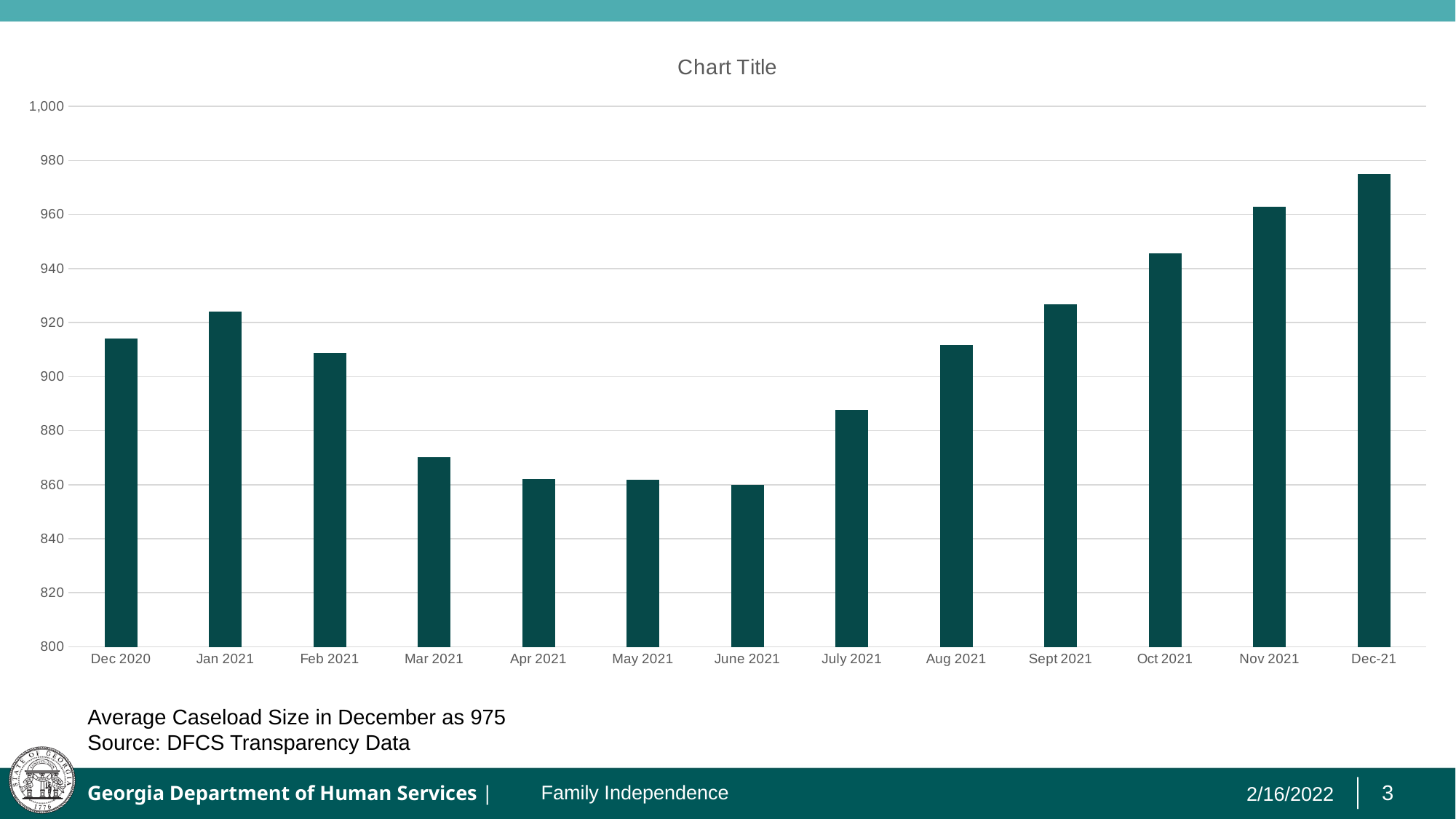
Which is larger, the value for Jan 2021 or the value for Feb 2021? Jan 2021 What source is cited for the chart data on the slide? DFCS Transparency Data Is the value for Dec 2020 greater or less than 900? greater Is the value for July 2021 greater or less than 900? less Which month has the highest bar? Dec-21 Which is larger, the value for Sept 2021 or the value for Oct 2021? Oct 2021 From June 2021 to Dec-21, do the values rise or fall? rise How many months (categories) are plotted on the x axis? 13 Is the value for Mar 2021 greater or less than 880? less According to the text on the slide, what was the average caseload size in December 2021 (the Dec-21 bar)? 975 What kind of chart is shown on the slide? bar chart